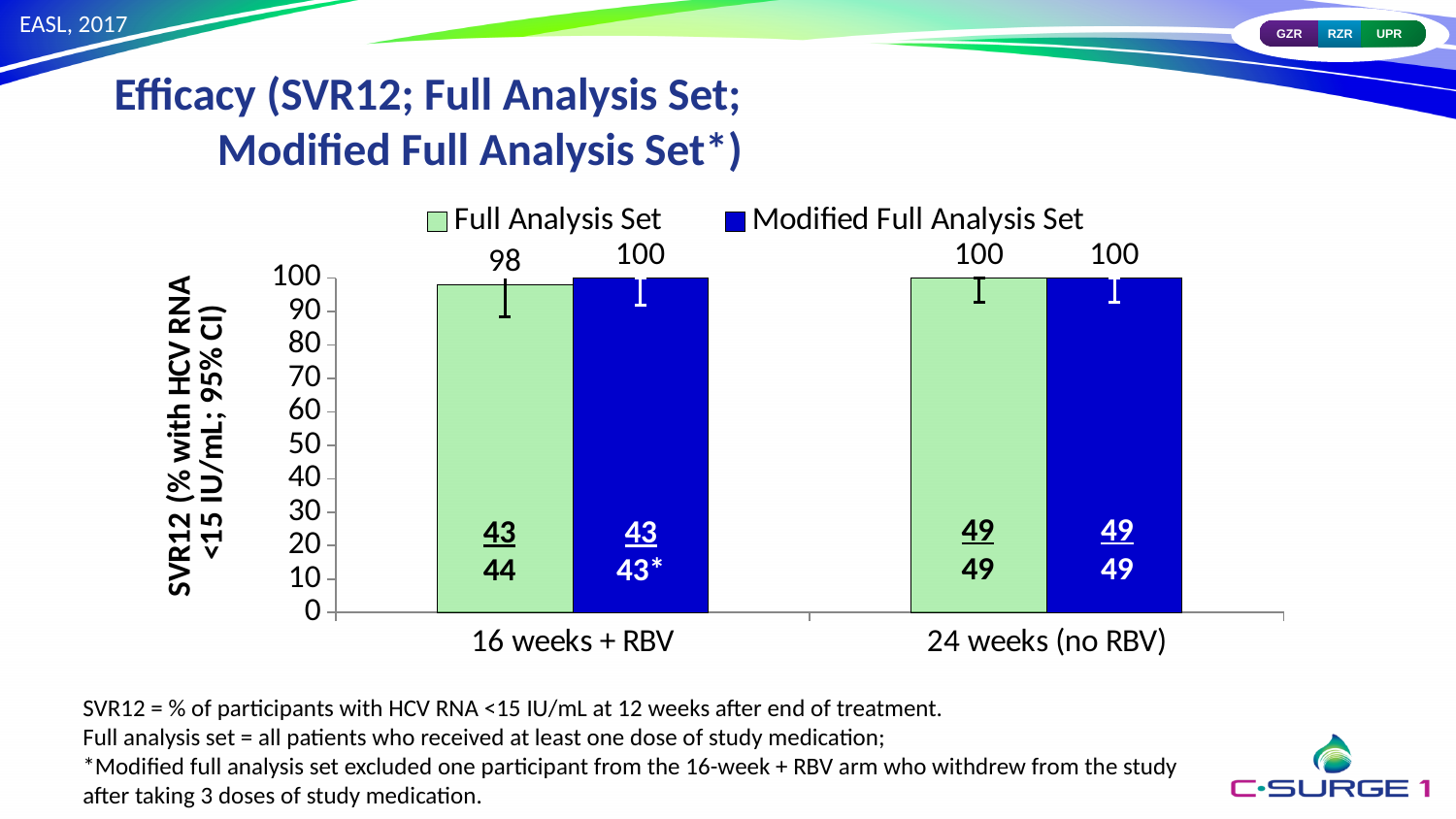
What fraction is printed inside the Full Analysis Set bar for the 16 weeks + RBV arm? 43/44 Which bar has the lowest SVR12 value on the chart? Full Analysis Set, 16 weeks + RBV What is the SVR12 value for the Full Analysis Set in the 16 weeks + RBV arm? 98 What is the difference between the Modified Full Analysis Set and Full Analysis Set SVR12 values in the 16 weeks + RBV arm? 2 What is the SVR12 value for the Modified Full Analysis Set in the 24 weeks (no RBV) arm? 100 What is the SVR12 value for the Modified Full Analysis Set in the 16 weeks + RBV arm? 100 How many treatment arms (categories) are shown on the x axis? 2 What is the SVR12 value for the Full Analysis Set in the 24 weeks (no RBV) arm? 100 In the 16 weeks + RBV arm, which is larger: the Full Analysis Set value or the Modified Full Analysis Set value? Modified Full Analysis Set How many series does the legend list? 2 What kind of chart is shown on the slide? Bar chart What colour are the Modified Full Analysis Set bars? Dark blue